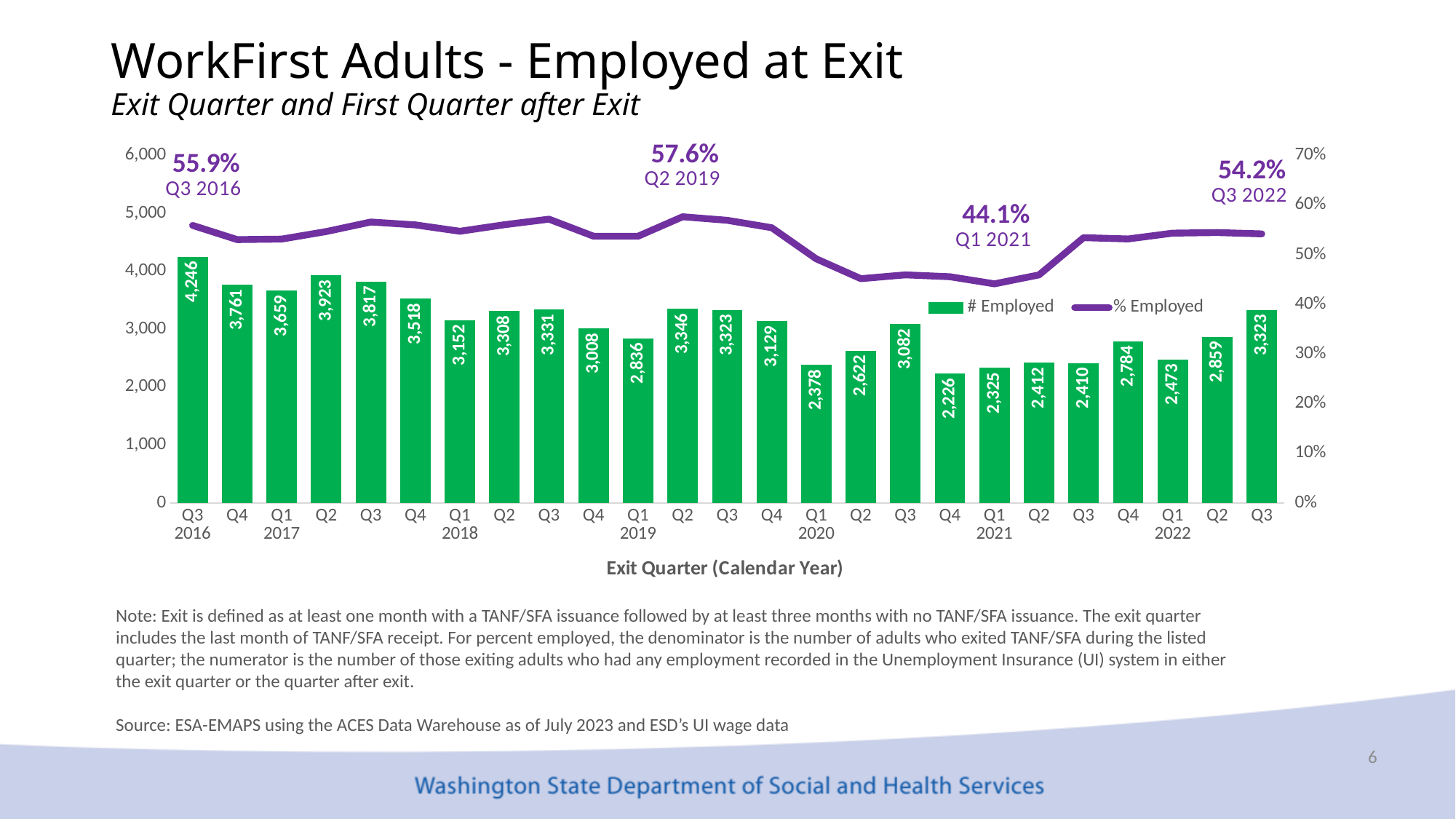
What is the # Employed value for Q4 2020? 2,226 How many adults were employed at exit in Q3 2016? 4,246 Which quarter has a larger # Employed, Q2 2017 or Q3 2017? Q2 2017 How many series does the legend list? 2 What is the % Employed value labeled for Q1 2021? 44.1% What percent of WorkFirst adults were employed at exit in Q2 2019? 57.6% What is the difference in # Employed between Q3 2016 and Q3 2022? 923 How many exit quarters are plotted on the chart? 25 Which exit quarter has the lowest # Employed? Q4 2020 What is the x-axis title of the chart? Exit Quarter (Calendar Year) Which exit quarter has the highest # Employed? Q3 2016 Is the % Employed value for Q2 2020 greater or less than 50%? less